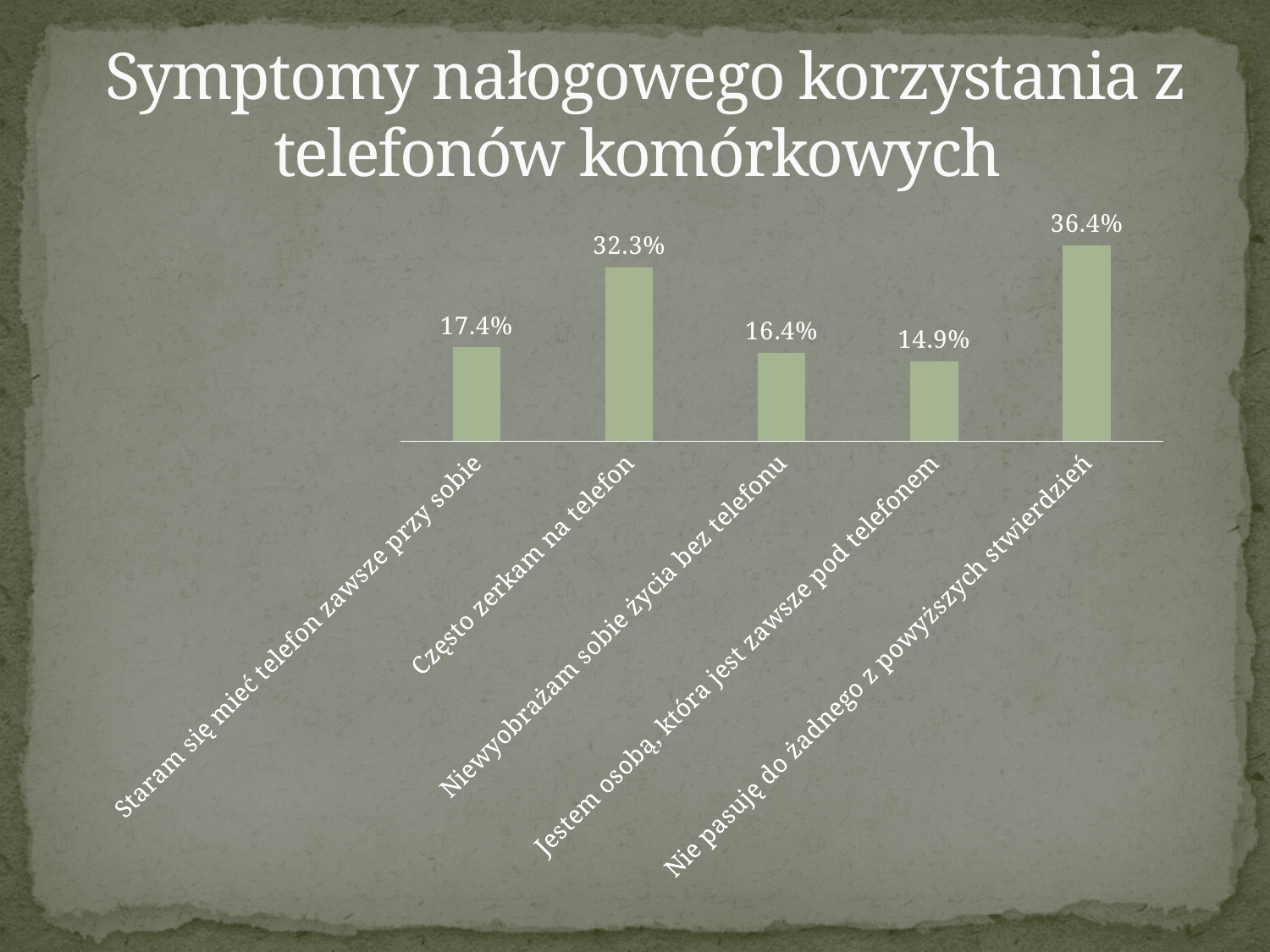
What is the value for "Często zerkam na telefon"? 32.3% What is the value for "Staram się mieć telefon zawsze przy sobie"? 17.4% How many categories are shown in the chart? 5 What is the title of the slide? Symptomy nałogowego korzystania z telefonów komórkowych What is the value for "Jestem osobą, która jest zawsze pod telefonem"? 14.9% Which category has the lowest value? Jestem osobą, która jest zawsze pod telefonem Which is larger: the value for "Często zerkam na telefon" or the value for "Niewyobrażam sobie życia bez telefonu"? Często zerkam na telefon What is the difference between the values for "Nie pasuję do żadnego z powyższych stwierdzień" and "Często zerkam na telefon"? 4.1% Which category has the highest value? Nie pasuję do żadnego z powyższych stwierdzień What is the difference between the values for "Staram się mieć telefon zawsze przy sobie" and "Niewyobrażam sobie życia bez telefonu"? 1.0% What is the value for "Nie pasuję do żadnego z powyższych stwierdzień"? 36.4% What kind of chart is shown on the slide? Bar chart